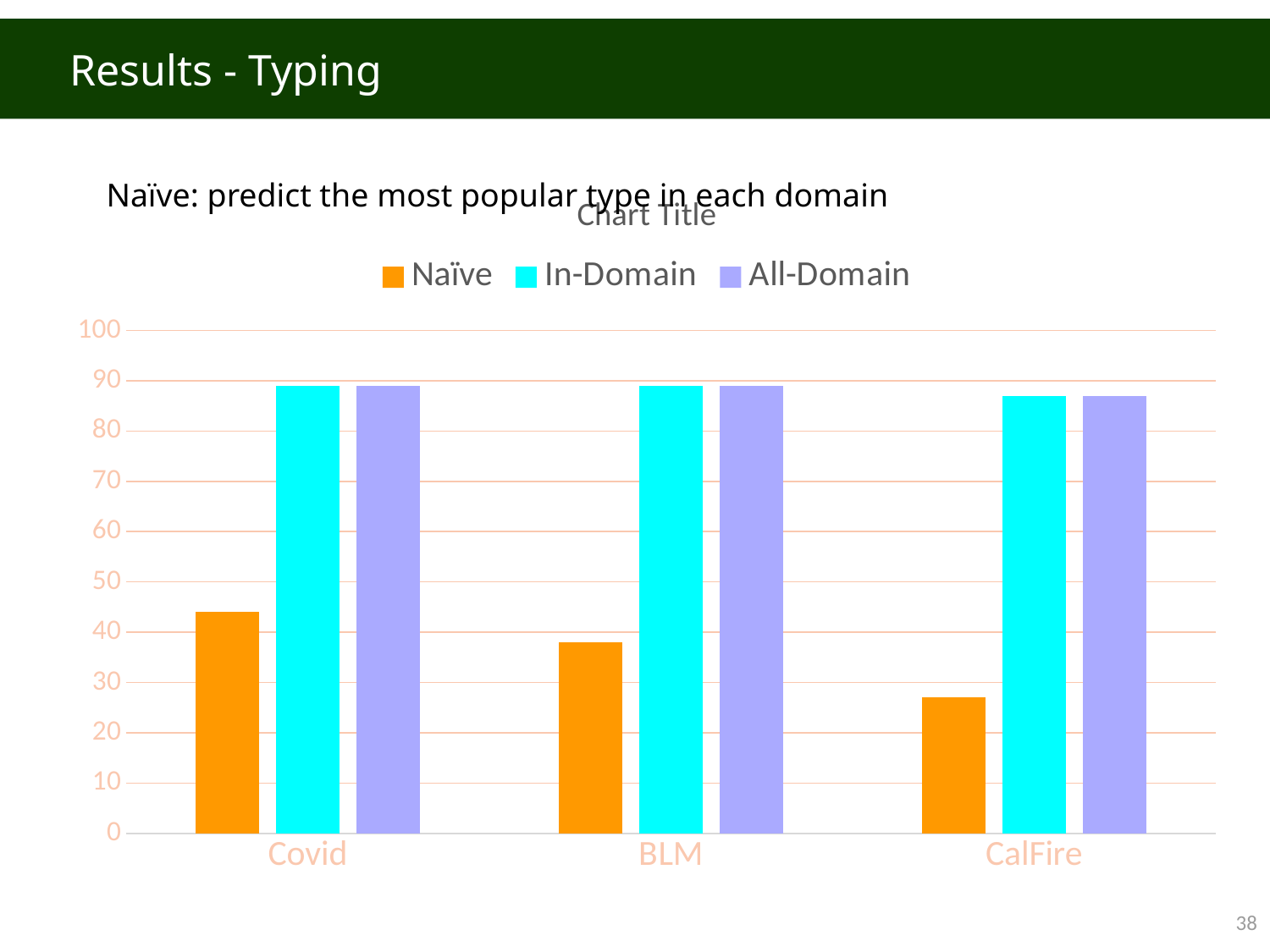
Is the In-Domain value for Covid greater or less than 80? greater How many categories are shown on the x axis? 3 What kind of chart is shown on the slide? bar chart Which category has the highest Naïve value? Covid For BLM, which is larger, the Naïve value or the In-Domain value? In-Domain Which series is shown in orange in the legend? Naïve Is the Naïve value for Covid greater or less than 40? greater Is the Naïve value for CalFire greater or less than 30? less How many series does the legend list? 3 Which category has the lowest Naïve value? CalFire What is the title shown above the legend? Chart Title